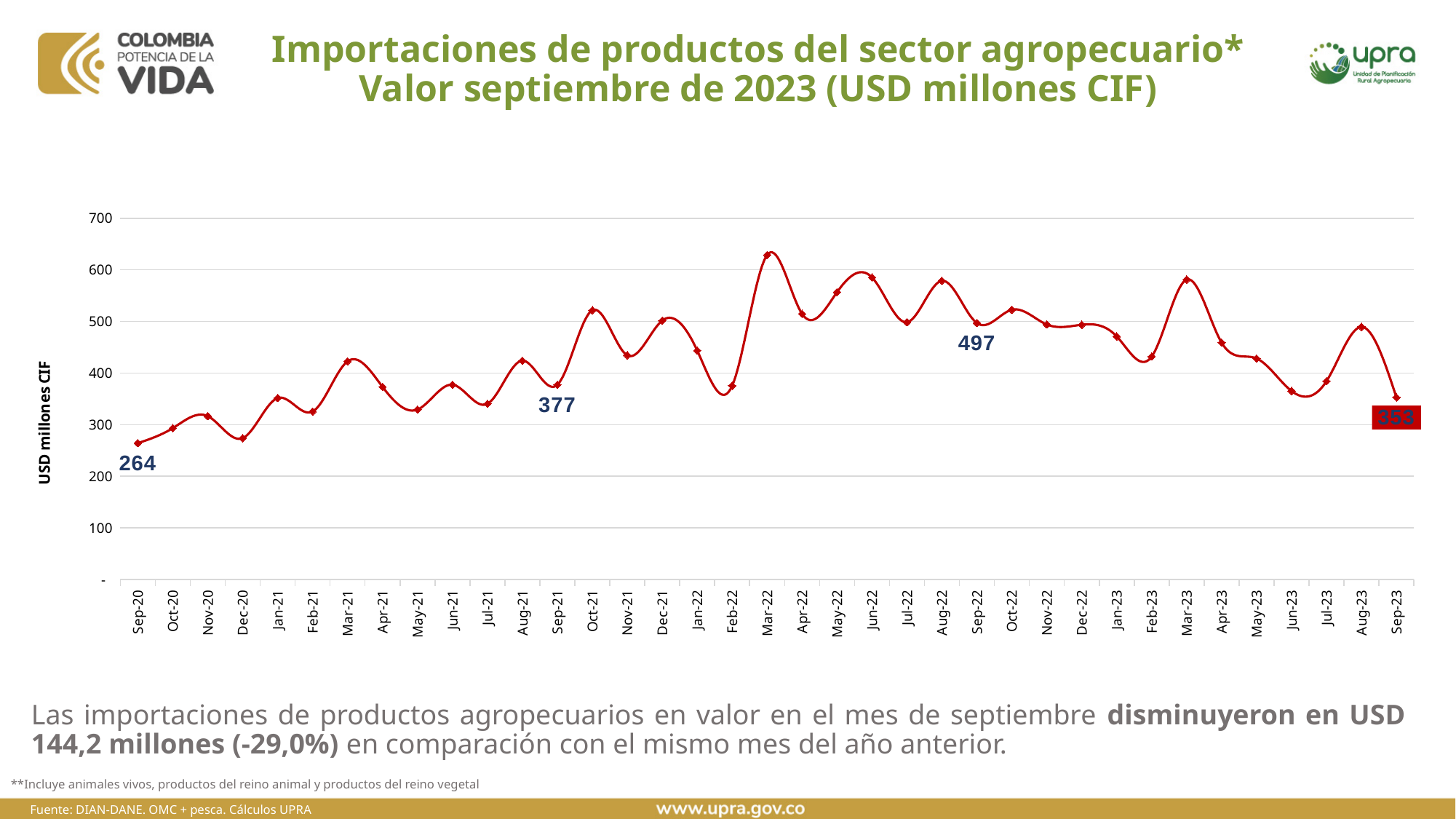
Which month has the highest value on the chart? Mar-22 Is the value for Mar-22 greater or less than 600? greater What is the value for Sep-21? 377 What type of chart is shown on the slide? Line chart What is the difference between the values for Sep-22 and Sep-23? 144 What is the difference between the values for Sep-21 and Sep-20? 113 What is the value for Sep-20? 264 What is the value for Sep-23? 353 What is the value for Sep-22? 497 Which is larger, the value for Sep-22 or the value for Sep-23? Sep-22 Is the value for Feb-22 greater or less than 400? less What is the label of the vertical axis? USD millones CIF